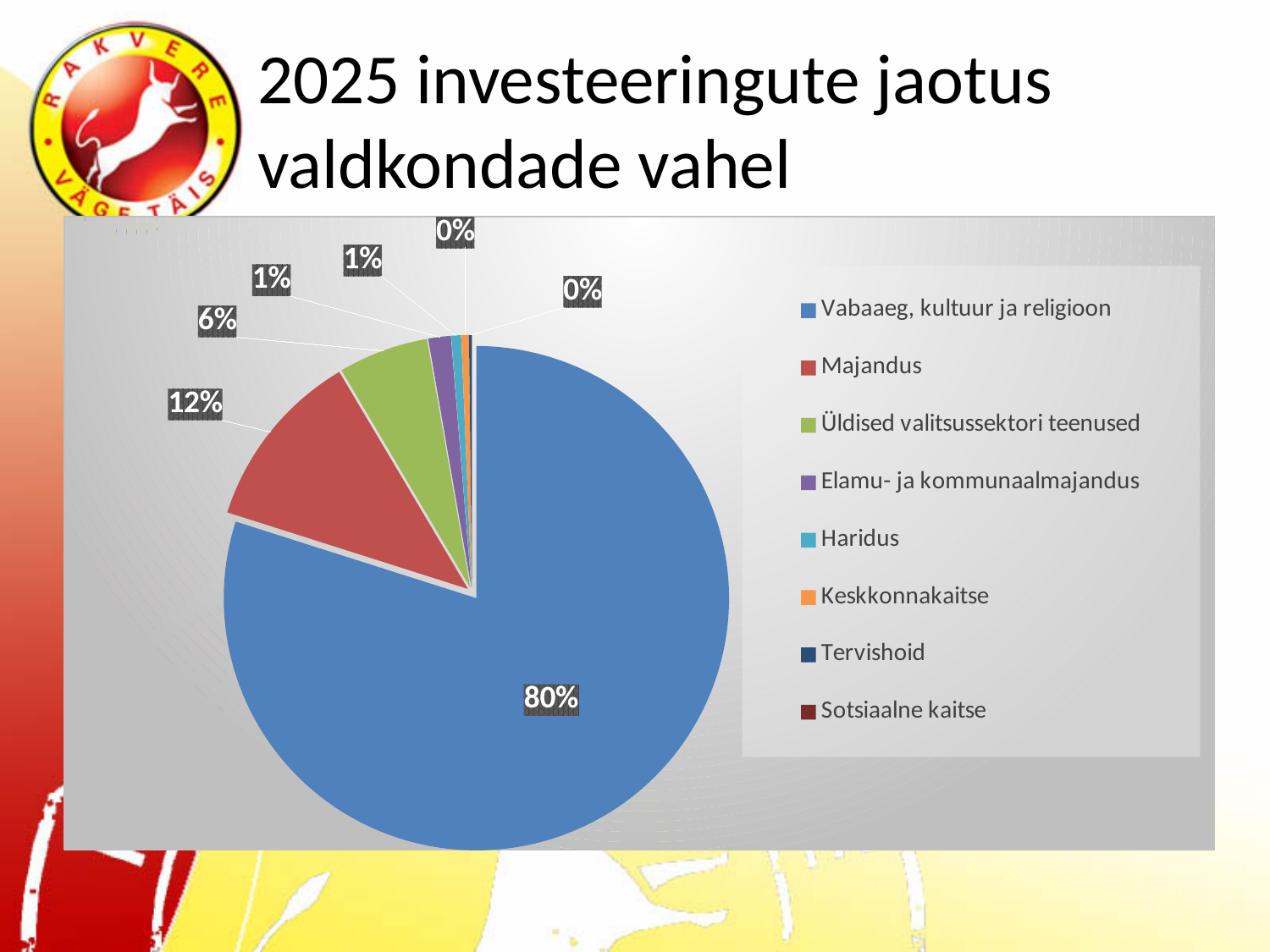
What share of the pie does Majandus have? 12% Which slice is larger, Majandus or Üldised valitsussektori teenused? Majandus Which slice is larger, Vabaaeg, kultuur ja religioon or Majandus? Vabaaeg, kultuur ja religioon How many categories does the legend list? 8 What share of the pie does Üldised valitsussektori teenused have? 6% What share of the pie does Vabaaeg, kultuur ja religioon have? 80% What colour is the Majandus slice in the pie chart? red What is the difference in percentage points between the Majandus slice and the Üldised valitsussektori teenused slice? 6 percentage points What is the difference in percentage points between the Vabaaeg, kultuur ja religioon slice and the Majandus slice? 68 percentage points What kind of chart is shown on the slide? pie chart What is the title of the slide containing the chart? 2025 investeeringute jaotus valdkondade vahel Which category has the largest slice of the pie? Vabaaeg, kultuur ja religioon